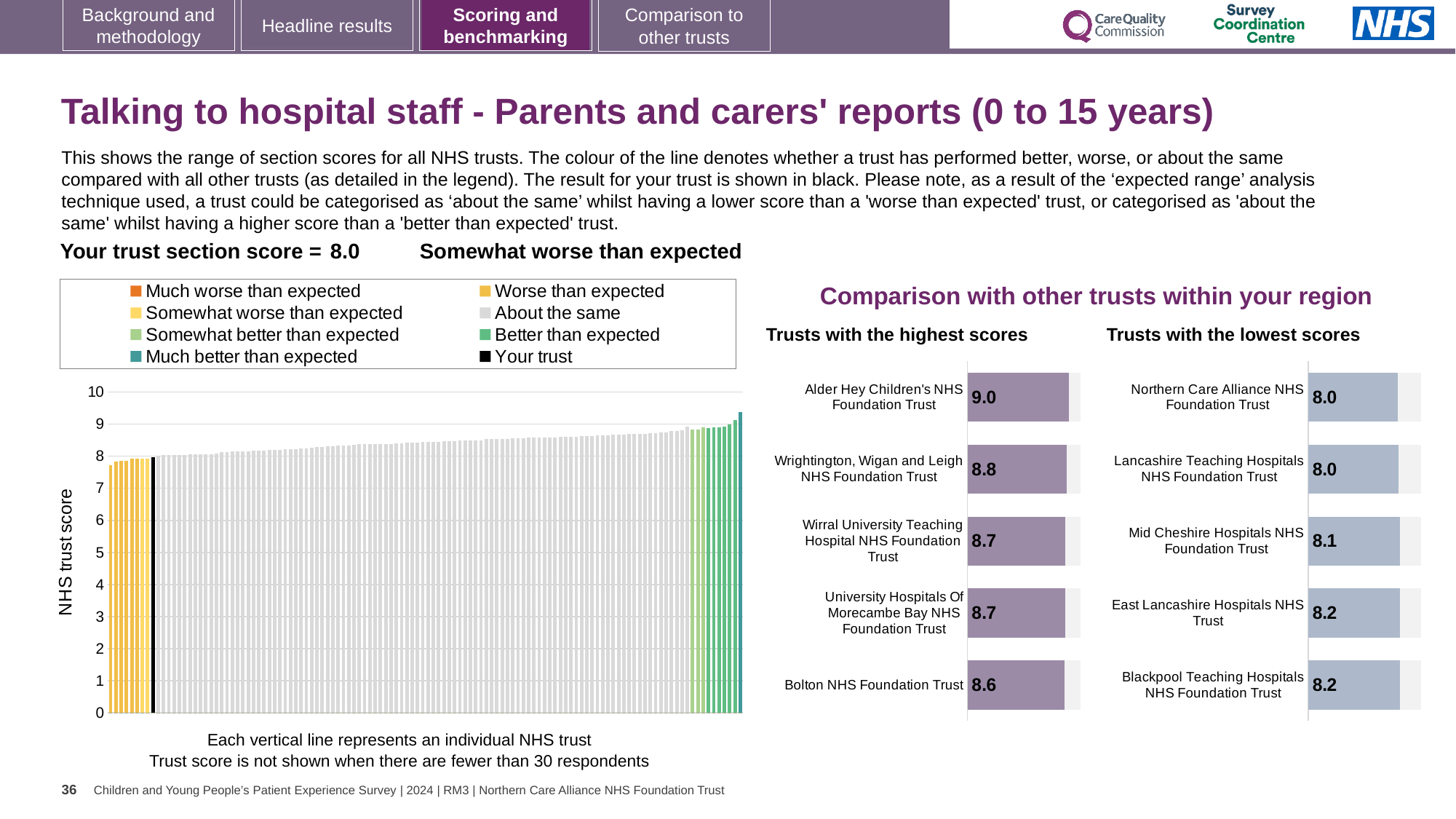
On the 'Trusts with the highest scores' chart, which trust has the highest score? Alder Hey Children's NHS Foundation Trust How many entries does the legend of the main 'NHS trust score' chart list? 8 How many trusts are shown on the 'Trusts with the lowest scores' chart? 5 On the main 'NHS trust score' chart on the left, do the bar values rise or fall from left to right? rise On the 'Trusts with the highest scores' chart, what is the score for Alder Hey Children's NHS Foundation Trust? 9.0 On the 'Trusts with the highest scores' chart, what is the score for Bolton NHS Foundation Trust? 8.6 On the main 'NHS trust score' chart on the left, is the value of the leftmost (lowest) bar greater or less than 8? less On the 'Trusts with the lowest scores' chart, what is the score for Blackpool Teaching Hospitals NHS Foundation Trust? 8.2 On the 'Trusts with the highest scores' chart, which has the larger score: Alder Hey Children's NHS Foundation Trust or Wrightington, Wigan and Leigh NHS Foundation Trust? Alder Hey Children's NHS Foundation Trust On the main 'NHS trust score' chart on the left, what is the section score for your trust? 8.0 On the 'Trusts with the highest scores' chart, what is the difference between the scores of Alder Hey Children's NHS Foundation Trust and Bolton NHS Foundation Trust? 0.4 On the 'Trusts with the lowest scores' chart, what is the score for Mid Cheshire Hospitals NHS Foundation Trust? 8.1